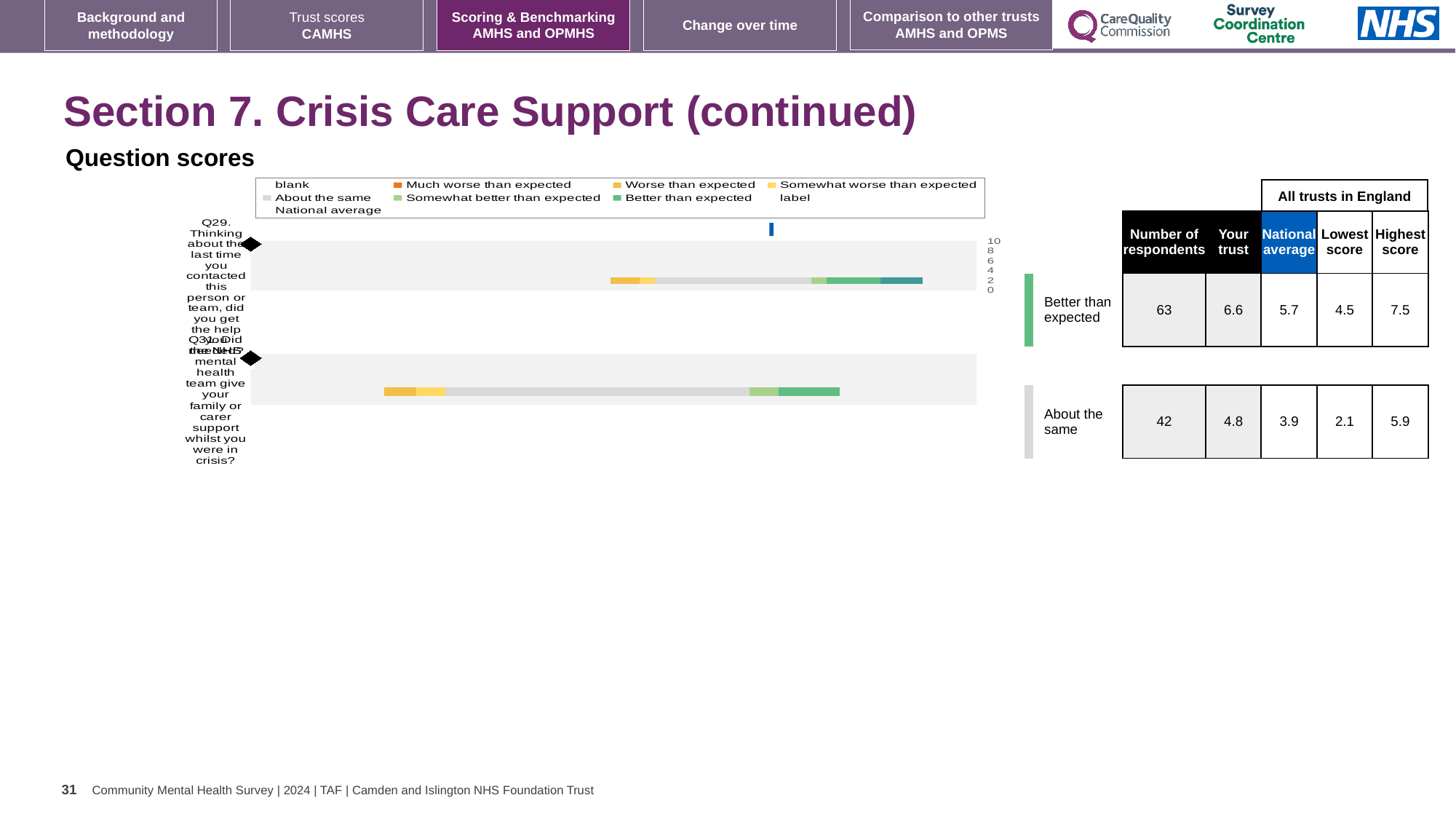
In the chart legend, what colour represents 'Better than expected'? green In the table beside the chart, what is the national average score for Q31? 3.9 In the table beside the chart, what is the highest score among all trusts in England for Q31? 5.9 Which question has more respondents, Q29 or Q31? Q29 What kind of chart is used to show the question scores on this slide? bar chart For Q29, is the 'Your trust' score higher or lower than the national average? higher In the table beside the chart, what is the lowest score among all trusts in England for Q29? 4.5 In the table beside the chart, what is the 'Your trust' score for Q29? 6.6 In the table beside the chart, how many respondents answered Q29? 63 In the chart legend, what colour represents 'Much worse than expected'? orange How many survey questions are plotted as bars in the question scores chart? 2 What is the difference between the 'Your trust' score and the national average for Q31? 0.9